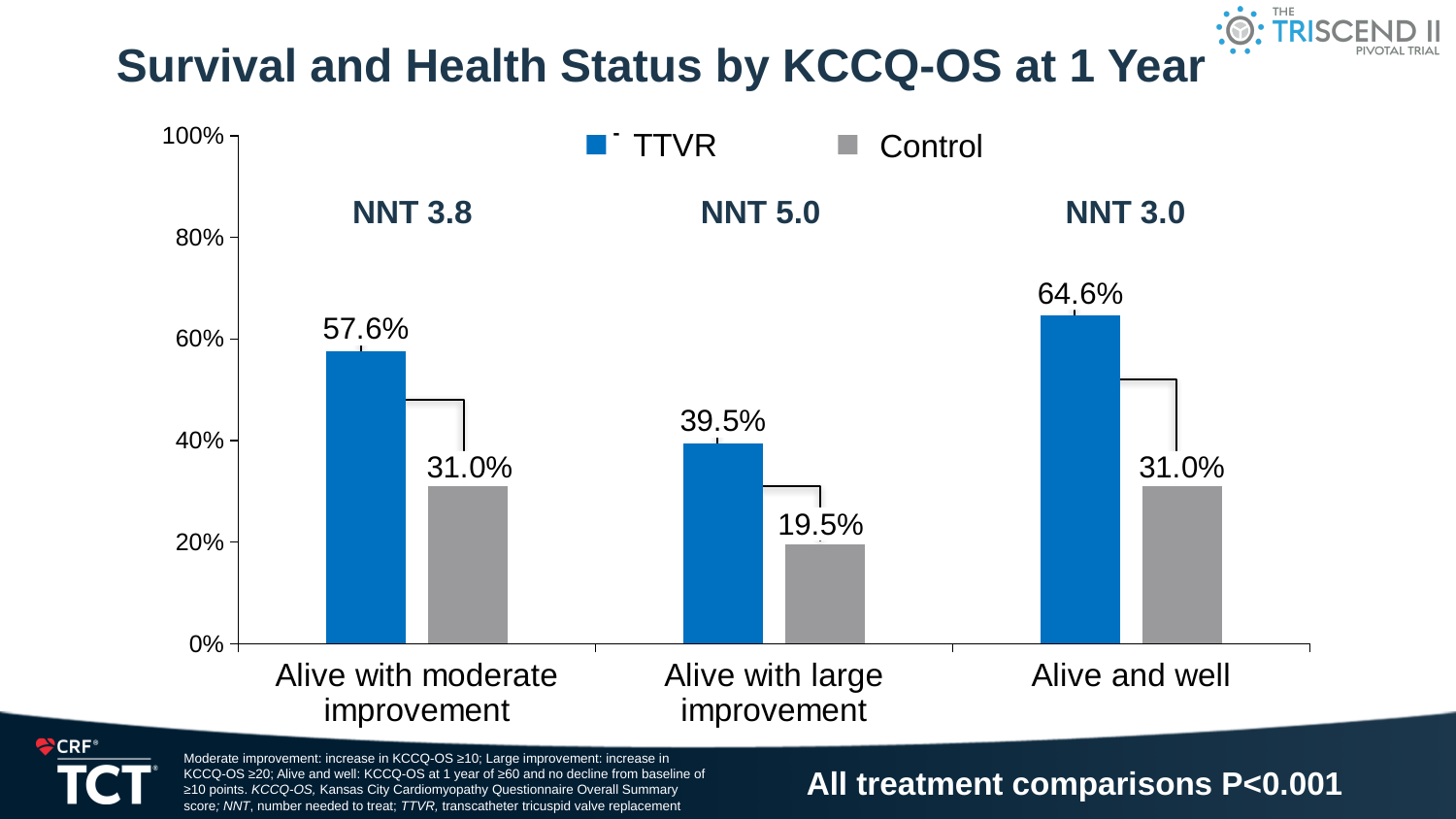
What is the TTVR value for 'Alive and well'? 64.6% Which category has the lowest Control value? Alive with large improvement What is the TTVR value for 'Alive with moderate improvement'? 57.6% What kind of chart is shown on the slide? Bar chart Is the TTVR value for 'Alive with large improvement' greater or less than 40%? less How many categories are shown on the x axis? 3 What is the difference between the TTVR and Control values for 'Alive and well'? 33.6% Which is larger for 'Alive with large improvement': the TTVR value or the Control value? TTVR How many series does the legend list? 2 What is the Control value for 'Alive with large improvement'? 19.5% Which category has the highest TTVR value? Alive and well What NNT value is shown above the 'Alive with large improvement' category? NNT 5.0